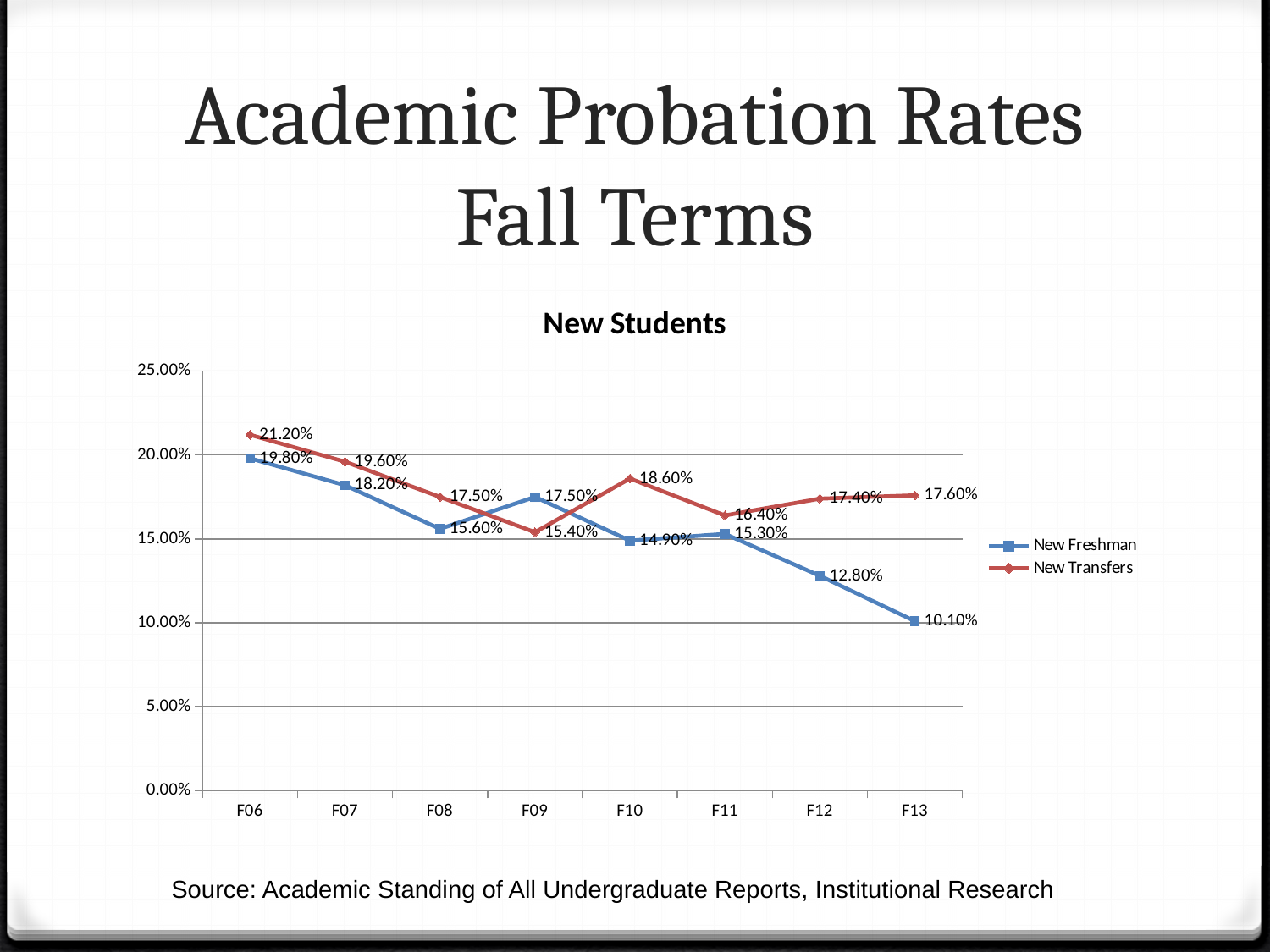
Is the New Freshman value for F12 greater or less than 15.00%? less Does the New Freshman rate generally rise or fall from F06 to F13? fall What is the difference between the New Transfers and New Freshman rates in F13? 7.50% In which fall term is the New Transfers rate highest? F06 What is the New Freshman academic probation rate for F13? 10.10% In F09, which series has the higher probation rate, New Freshman or New Transfers? New Freshman How many series does the legend list? 2 How many fall terms are shown on the x axis? 8 What kind of chart is shown on the slide? line chart What is the New Transfers value for F11? 16.40% In which fall term is the New Freshman rate lowest? F13 What is the New Transfers academic probation rate for F06? 21.20%